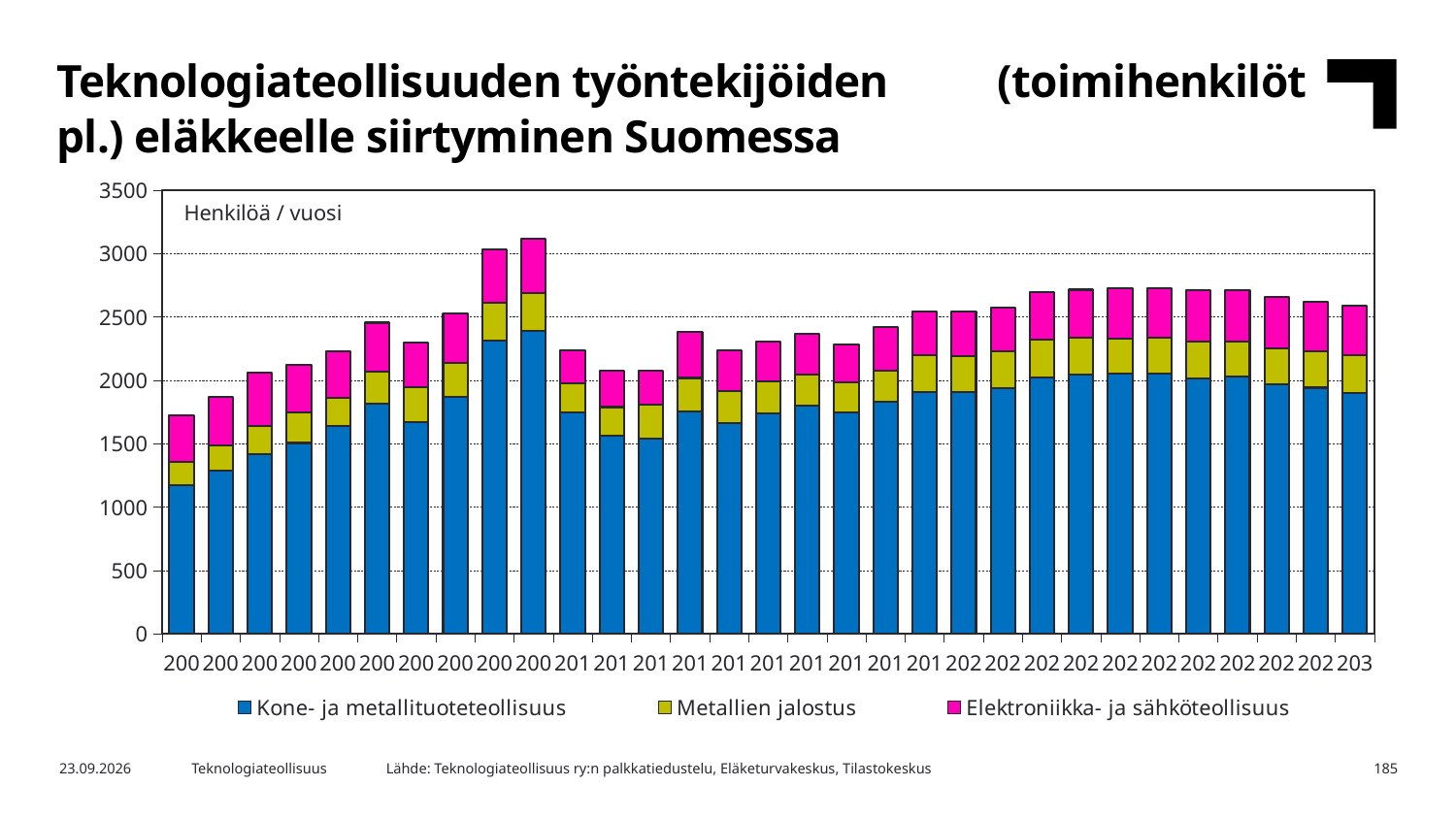
Is the total of the first (leftmost) bar greater or less than 2000? less What is the maximum value shown on the vertical axis? 3500 Which series is shown in blue in the legend? Kone- ja metallituoteteollisuus Which series forms the smallest segment in every bar? Metallien jalostus How many series does the legend list? 3 Is the total of the tallest bar greater or less than 3000? greater Which series forms the largest segment in every bar? Kone- ja metallituoteteollisuus Is the total of the last (rightmost) bar greater or less than 2500? greater What kind of chart is shown on the slide? Stacked bar chart How many bars are plotted in the chart? 31 What unit label is printed inside the plot area? Henkilöä / vuosi